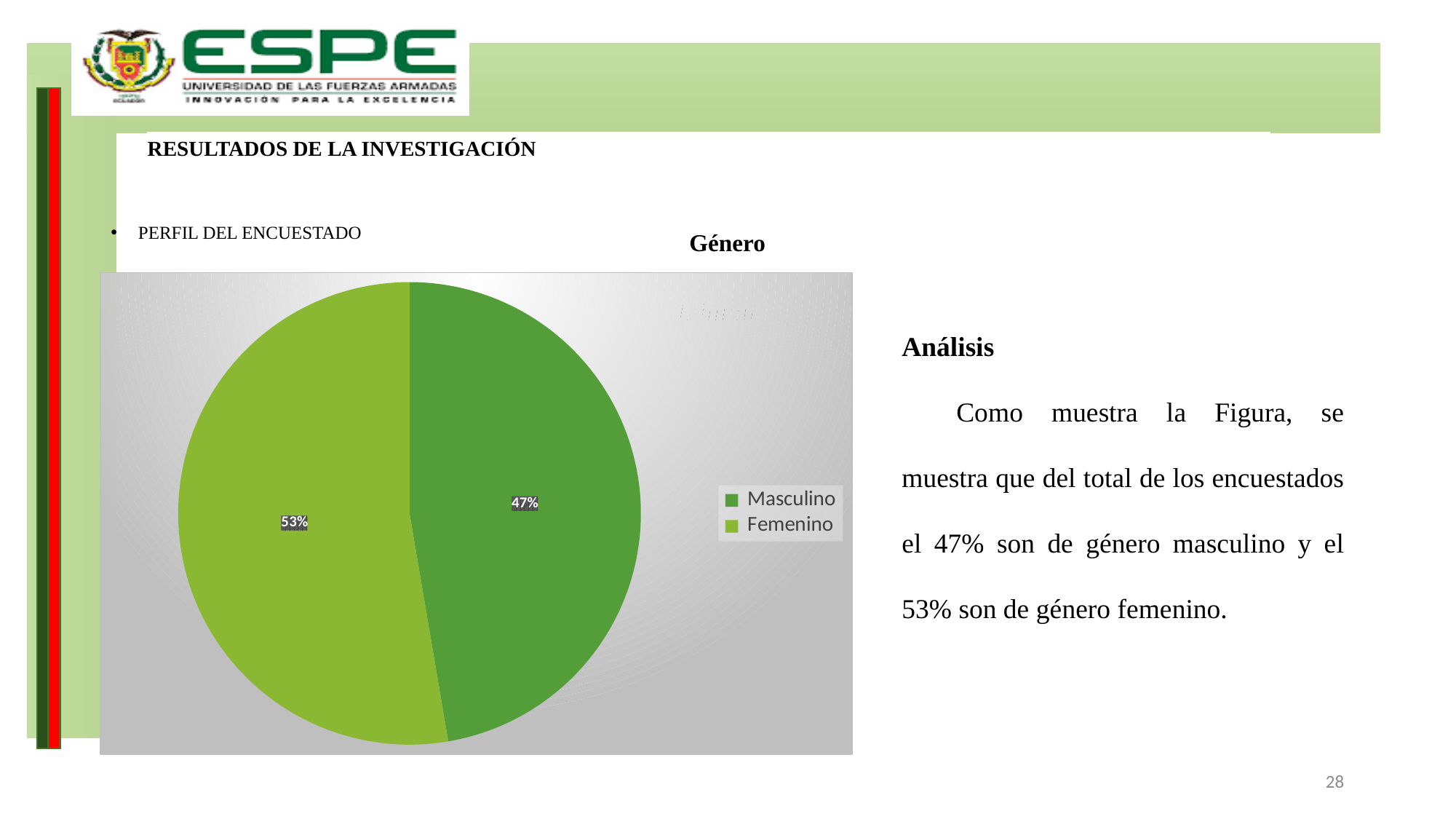
What is the difference in percentage points between the Femenino and Masculino slices? 6% What is the total of the two slices shown in the pie chart? 100% Which legend entry is shown in the lighter green colour? Femenino What share of the pie does Femenino represent? 53% What kind of chart is shown on the slide? Pie chart What share of the pie does Masculino represent? 47% Which category has the largest slice of the pie? Femenino Which category has the smallest slice of the pie? Masculino Which is larger, the Masculino slice or the Femenino slice? Femenino How many slices does the pie chart have? 2 What is the title of the chart? Género How many entries does the legend list? 2